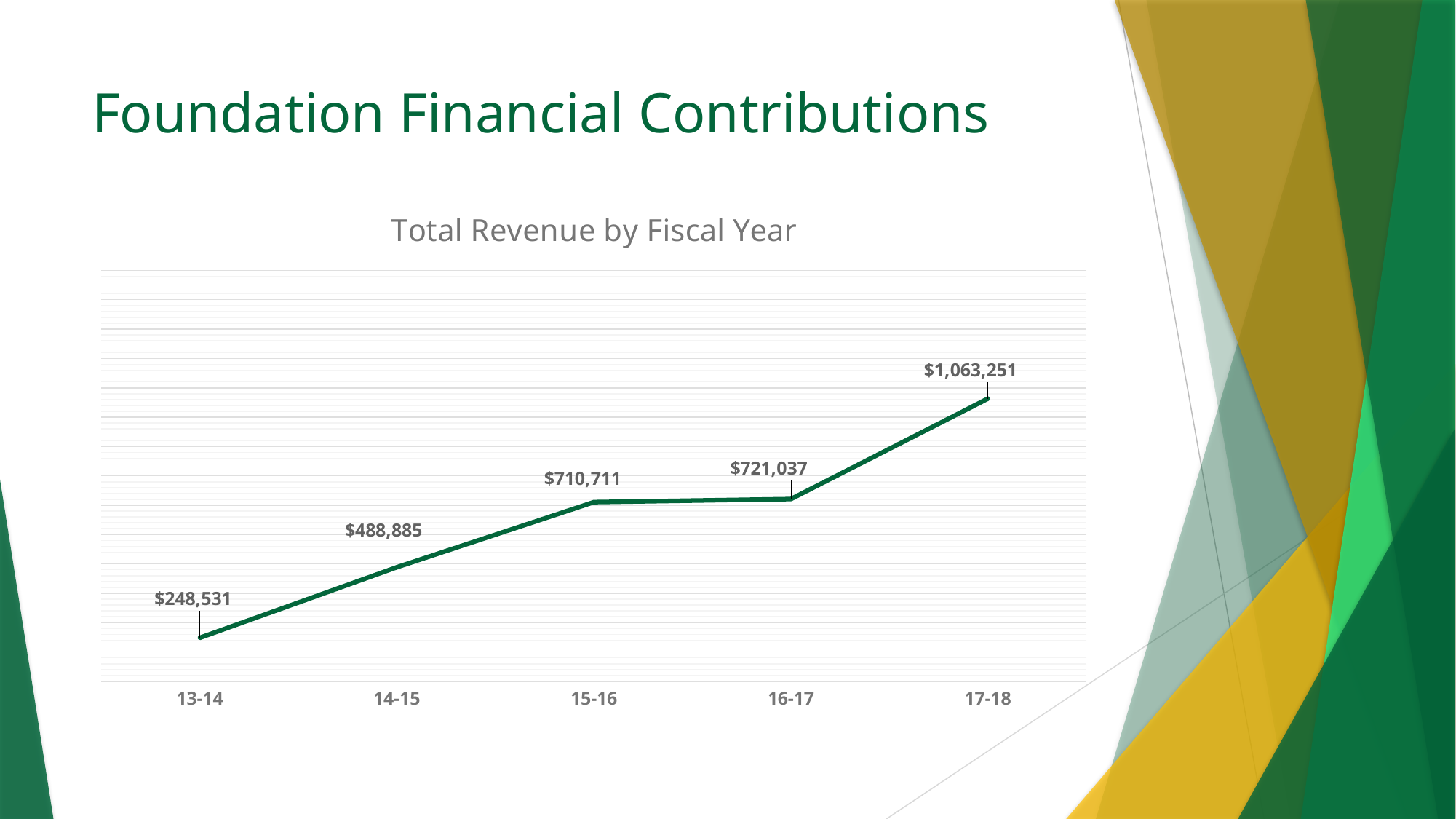
How many fiscal years are plotted on the chart? 5 What is the difference in total revenue between fiscal years 14-15 and 13-14? $240,354 What kind of chart is shown on the slide? Line chart Does total revenue rise or fall from fiscal year 13-14 to 17-18? Rise Which fiscal year has the highest total revenue? 17-18 What is the total revenue for fiscal year 17-18? $1,063,251 What is the total revenue for fiscal year 13-14? $248,531 Which fiscal year has higher total revenue, 15-16 or 16-17? 16-17 Which fiscal year has the lowest total revenue? 13-14 What is the total revenue for fiscal year 14-15? $488,885 What is the difference in total revenue between fiscal years 17-18 and 16-17? $342,214 What is the total revenue for fiscal year 16-17? $721,037